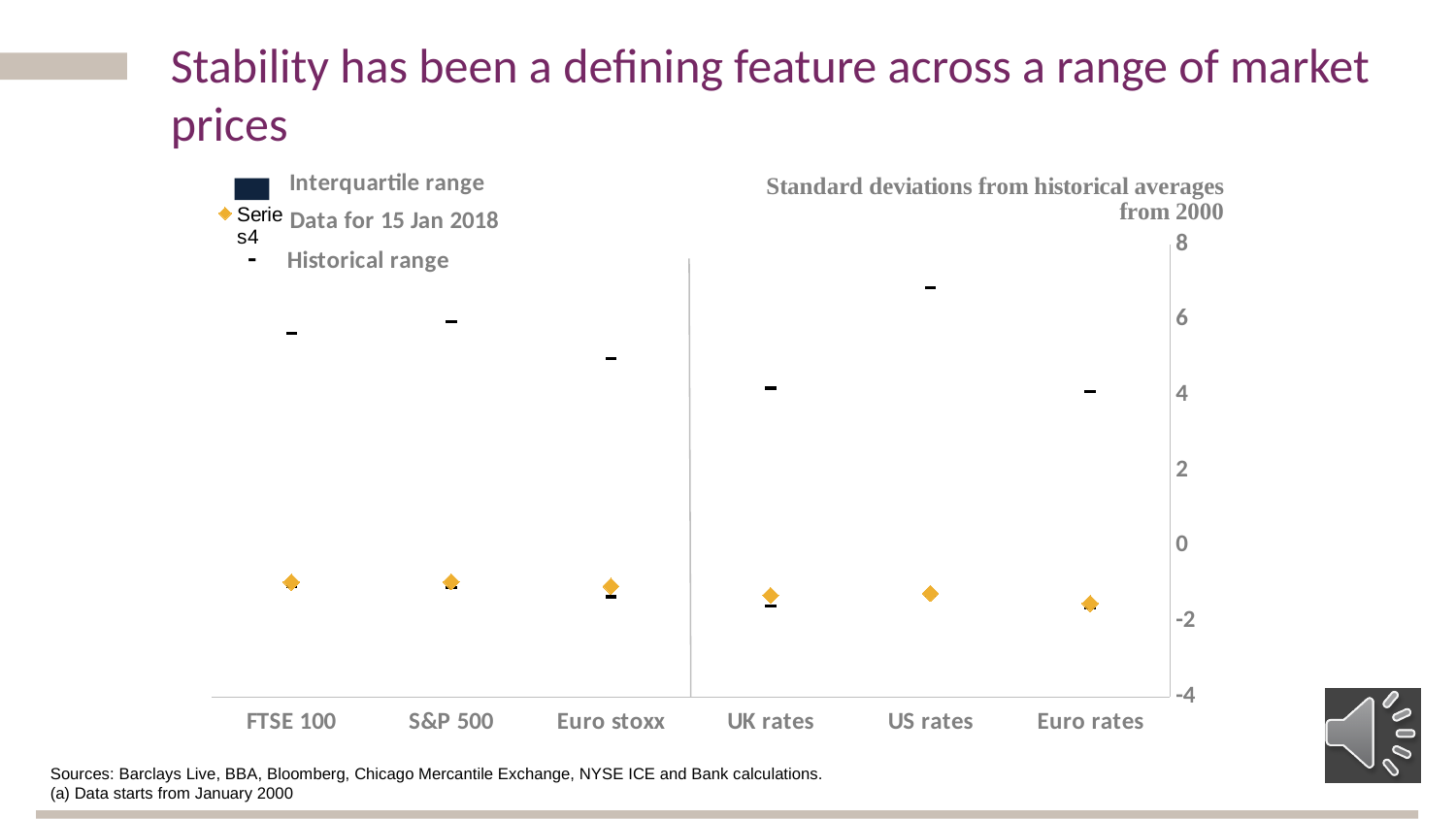
Is the upper historical range marker for US rates larger than that for Euro rates? Yes Which category has the highest upper historical range marker? US rates Is the upper historical range marker for UK rates greater or less than 6? less Is the 15 Jan 2018 data point for Euro rates greater or less than -2? greater Is the upper historical range marker for US rates greater or less than 6? greater What is the highest value shown on the y axis? 8 How many series does the chart's legend list? 3 How many categories are shown along the x axis of the chart? 6 What does the y axis of the chart measure, according to its label? Standard deviations from historical averages from 2000